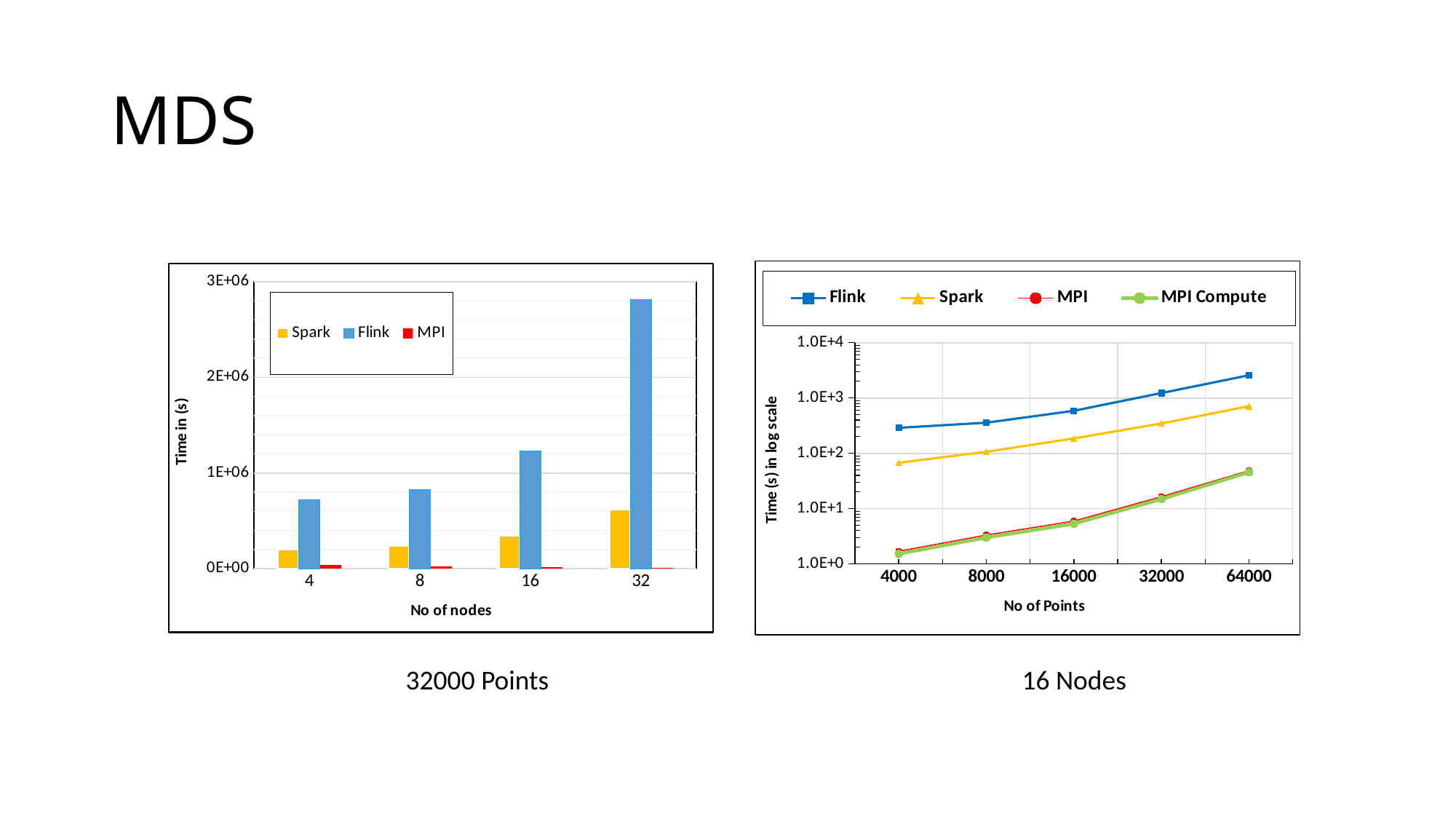
In the right chart (16 Nodes), what is the label of the x axis? No of Points In the left chart (32000 Points), at which number of nodes is the Flink bar highest? 32 In the left chart (32000 Points), is the Spark value at 32 nodes greater or less than 1E+06? less In the left chart (32000 Points), what kind of chart is shown? bar chart In the left chart (32000 Points), how many series does the legend list? 3 In the right chart (16 Nodes), which series has the highest time at 64000 points? Flink In the left chart (32000 Points), is the Flink value at 32 nodes greater or less than 2E+06? greater In the left chart (32000 Points), does the Flink time rise or fall as the number of nodes increases? rise In the left chart (32000 Points), how many node counts are shown on the x axis? 4 In the right chart (16 Nodes), is the Flink value at 64000 points greater or less than 1.0E+3? greater In the left chart (32000 Points), which series is larger at 16 nodes, Spark or Flink? Flink In the right chart (16 Nodes), how many series does the legend list? 4